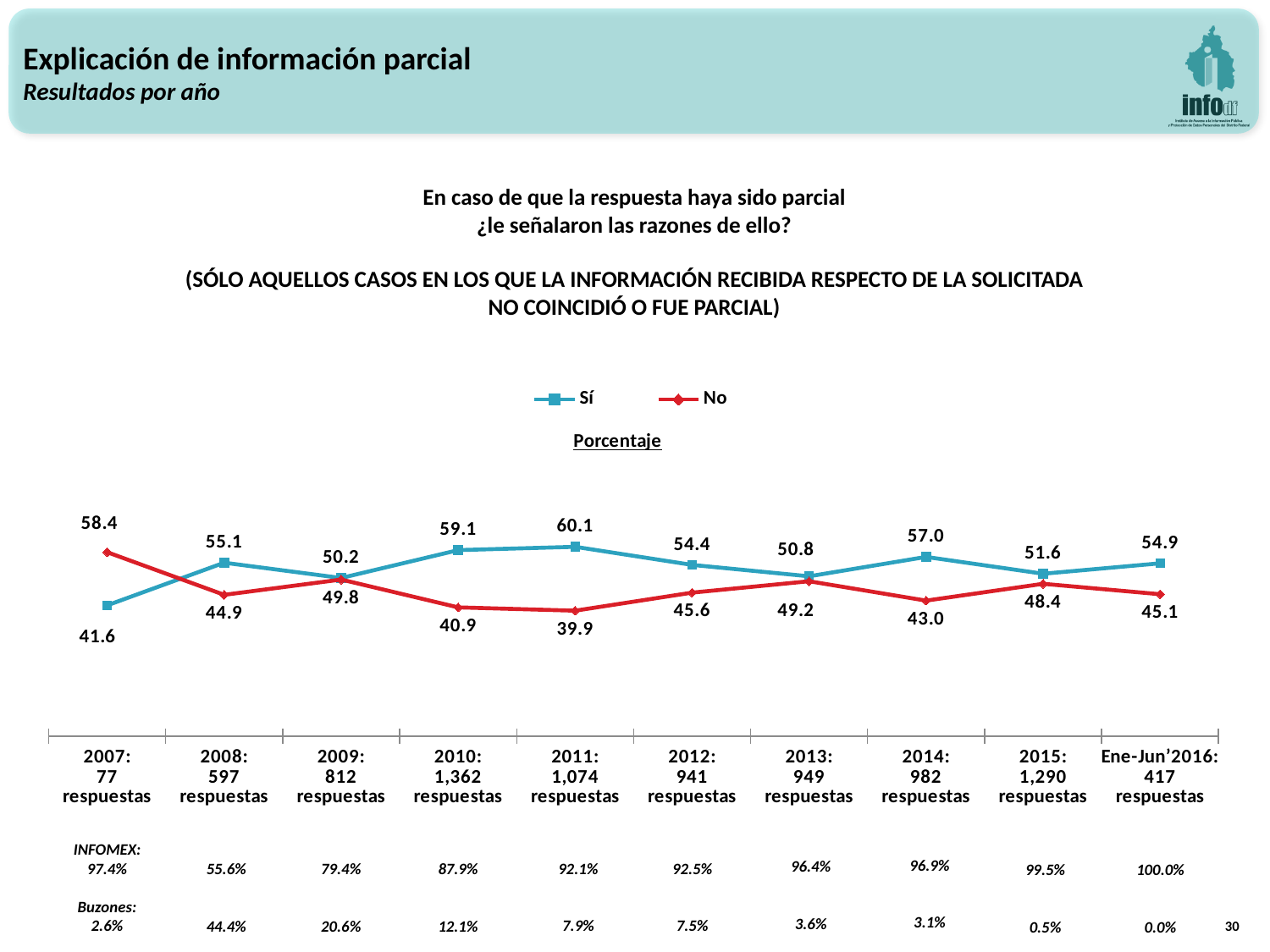
How many years (categories) are plotted on the x axis? 10 What is the value of the Sí series for Ene-Jun'2016? 54.9 What kind of chart is shown on the slide? Line chart What is the difference between the Sí and No values in 2014? 14.0 What is the value of the Sí series for 2011? 60.1 Which series has the larger value in 2010, Sí or No? Sí How many series does the legend list? 2 Which colour is used for the No series? Red What is the value of the No series for 2007? 58.4 In which year does the No series reach its lowest value? 2011 In which year does the Sí series reach its highest value? 2011 Which series has the larger value in 2007, Sí or No? No